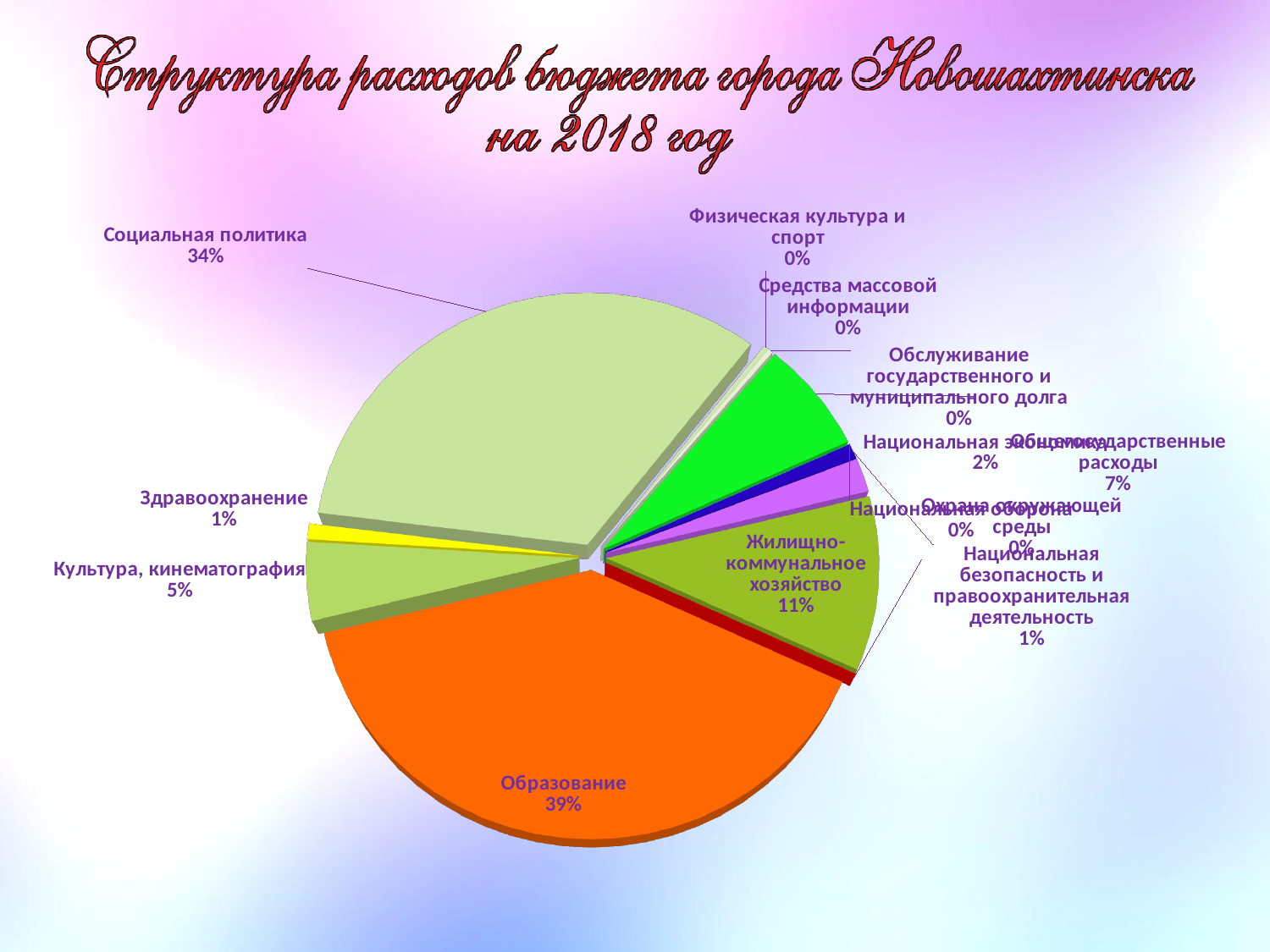
What share of expenditure is labelled for Здравоохранение? 1% What share of expenditure is labelled for Жилищно-коммунальное хозяйство? 11% What kind of chart is shown on the slide? pie chart What share of expenditure is labelled for Общегосударственные расходы? 7% What share of expenditure is labelled for Образование? 39% By how many percentage points does the share for Образование exceed the share for Социальная политика? 5 percentage points Which category has the largest share of the budget expenditure? Образование Which year does the chart title say the budget expenditure structure refers to? 2018 What share of expenditure is labelled for Физическая культура и спорт? 0% Which has the larger share: Жилищно-коммунальное хозяйство or Культура, кинематография? Жилищно-коммунальное хозяйство What share of expenditure is labelled for Социальная политика? 34% What share of expenditure is labelled for Культура, кинематография? 5%